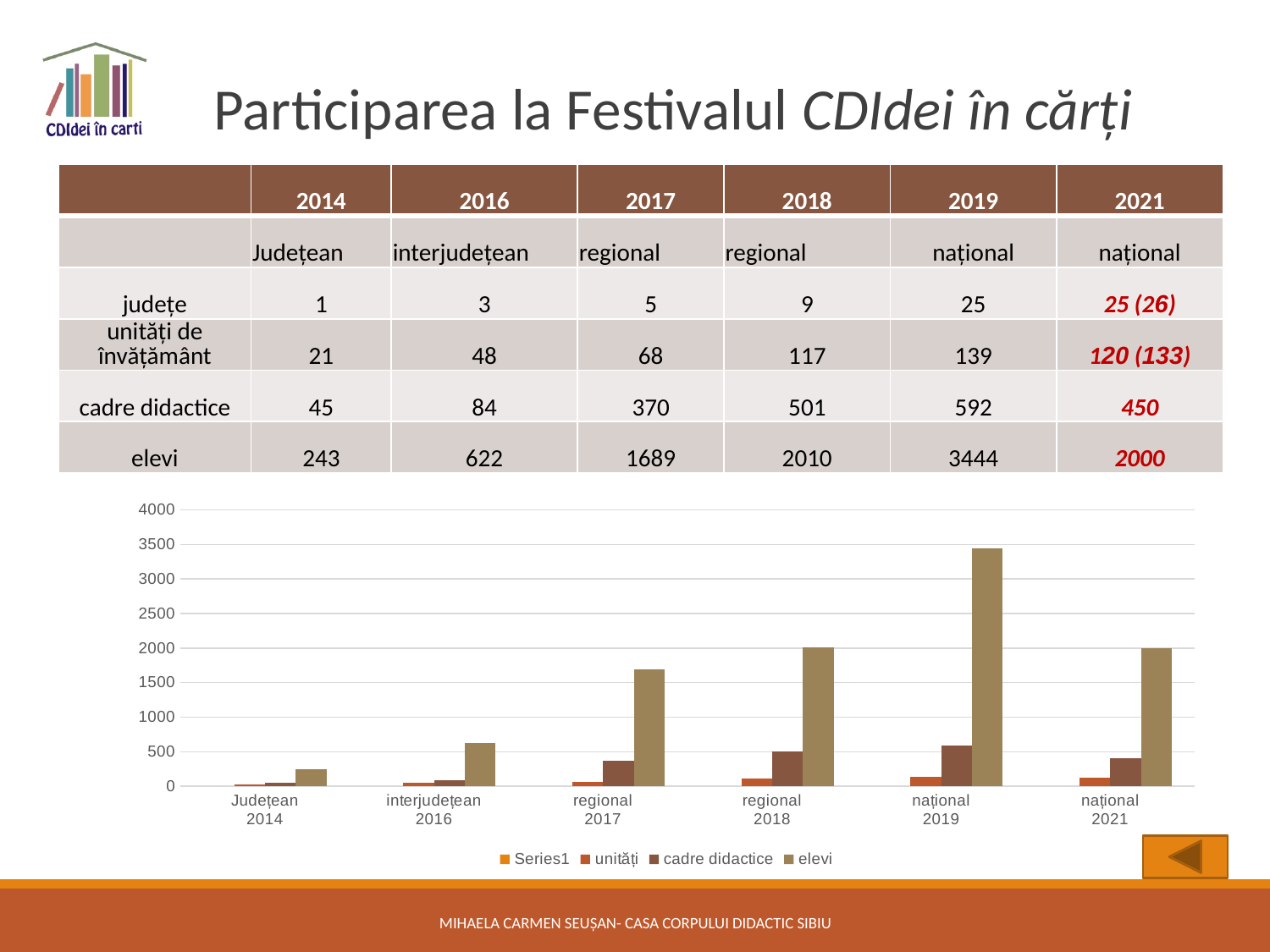
What kind of chart is shown on the slide? bar chart How many category groups are shown along the x axis of the chart? 6 According to the table, what is the elevi value for național 2019? 3444 Which category has the lowest bar for elevi? Județean 2014 Is the elevi value for național 2019 greater or less than 3000? greater Which category has the highest bar for elevi? național 2019 What is the difference between the elevi values for 2019 and 2018 as given in the table? 1434 Do the elevi values rise or fall from 2014 to 2019? rise Is the elevi value for Județean 2014 greater or less than 500? less Which is larger, the elevi bar for regional 2017 or regional 2018? regional 2018 How many series does the chart legend list? 4 Is the cadre didactice value for național 2019 greater or less than 500? greater